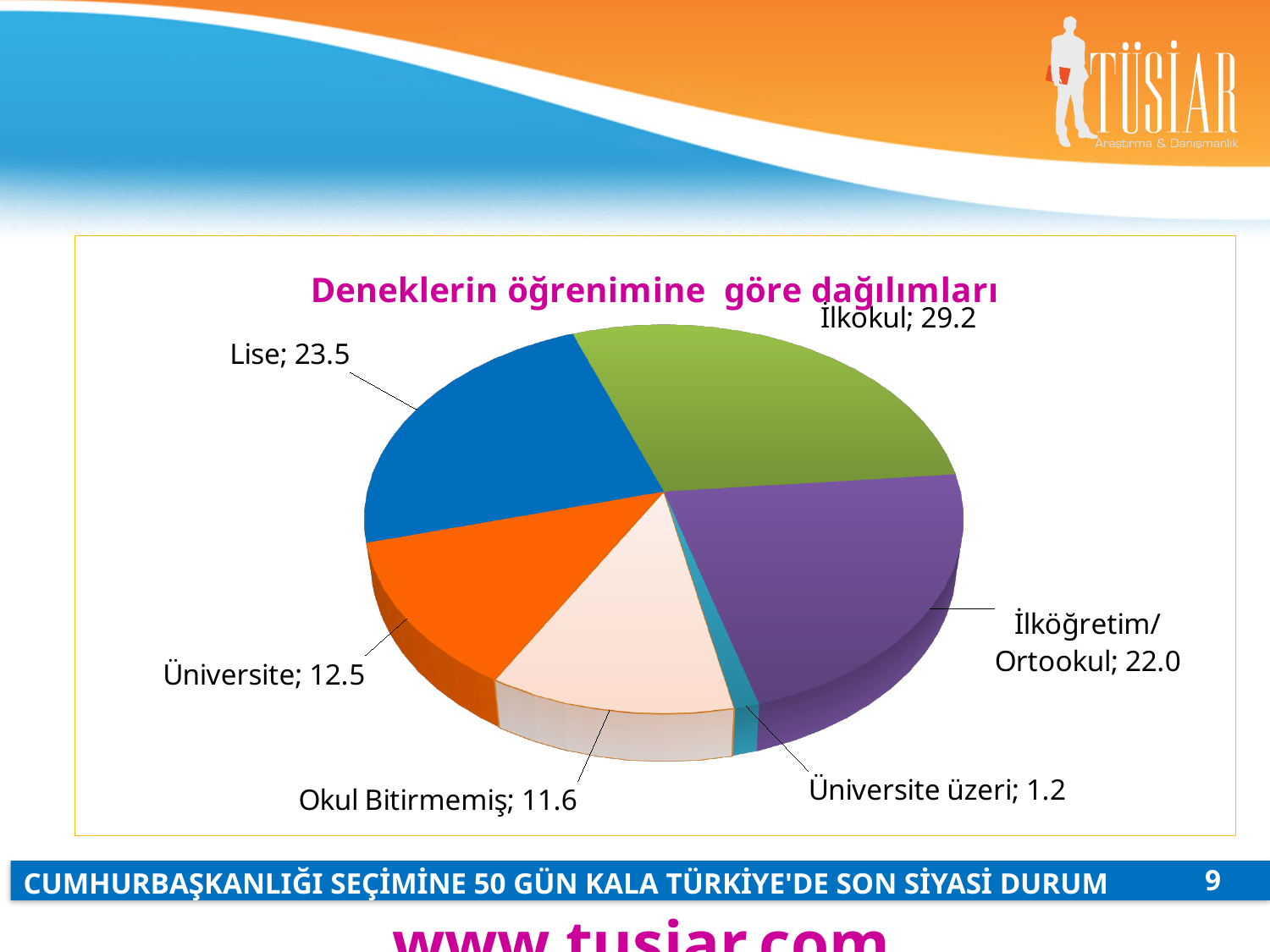
Which category has the largest slice? İlkokul How many slices does the pie chart have? 6 What is the difference between the values for İlköğretim/Ortookul and Üniversite? 9.5 Which is larger, the value for Üniversite or the value for Okul Bitirmemiş? Üniversite What is the value for Lise? 23.5 What is the value for İlkokul? 29.2 What is the title of the chart? Deneklerin öğrenimine göre dağılımları What is the difference between the values for İlkokul and Lise? 5.7 Which category has the smallest slice? Üniversite üzeri What is the value for Üniversite üzeri? 1.2 What kind of chart is shown on the slide? pie chart What is the value for Okul Bitirmemiş? 11.6